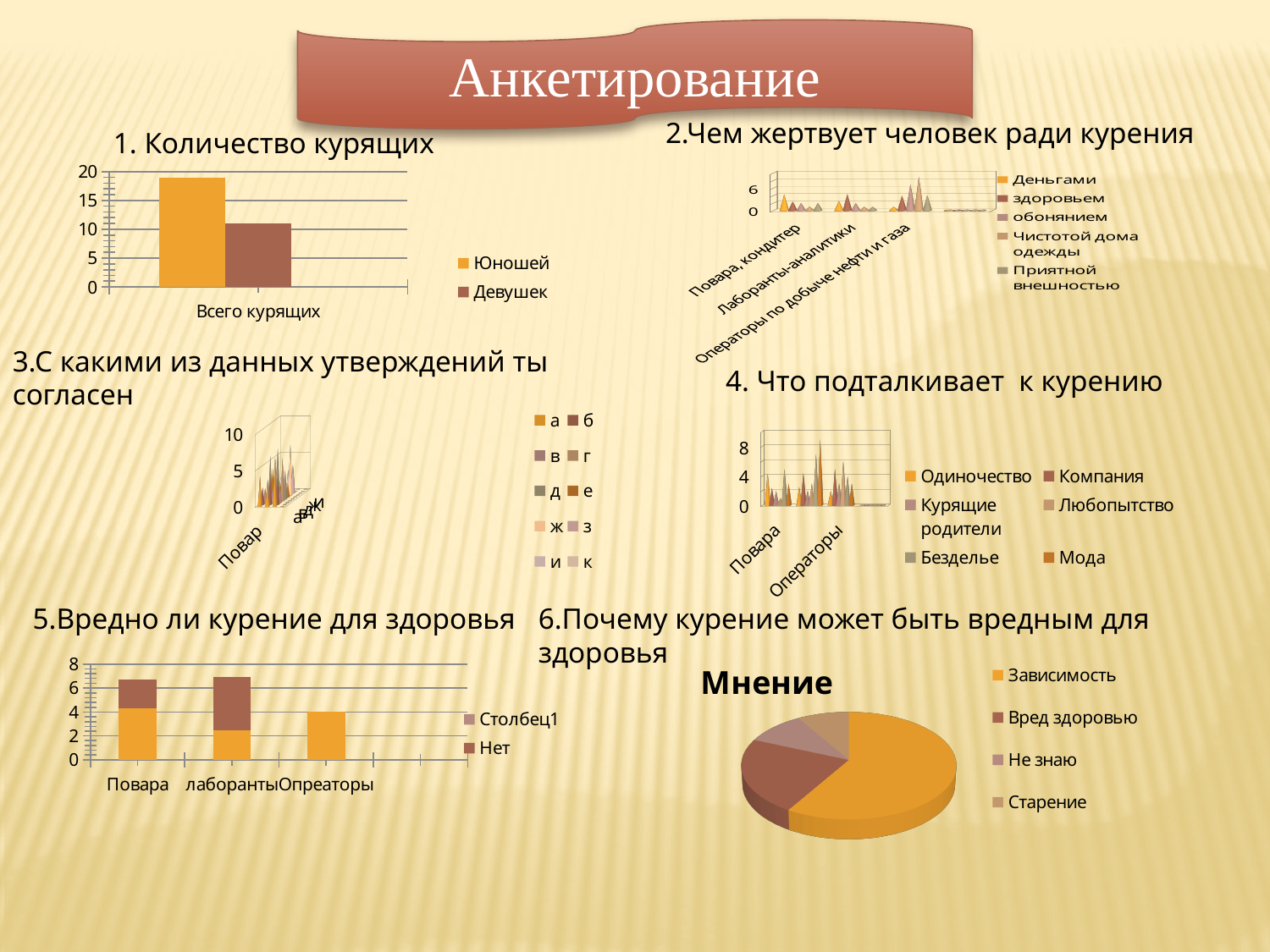
What kind of chart is chart 6, "Мнение"? pie chart What are the two legend entries of chart 5, "Вредно ли курение для здоровья"? Столбец1, Нет In chart 6, "Мнение", which legend entry corresponds to the largest slice? Зависимость In chart 5, "Вредно ли курение для здоровья", is the total stacked value for Повара greater or less than 6? greater In chart 1, "Количество курящих", is the value for Девушек greater or less than 15? less How many series does the legend of chart 2, "Чем жертвует человек ради курения", list? 5 How many series does the legend of chart 3, "С какими из данных утверждений ты согласен", list? 10 How many categories are shown on the x axis of chart 2, "Чем жертвует человек ради курения"? 3 In chart 1, "Количество курящих", is the value for Юношей greater or less than 15? greater In chart 1, "Количество курящих", which series has the taller bar, Юношей or Девушек? Юношей How many series does the legend of chart 4, "Что подталкивает к курению", list? 6 What kind of chart is chart 1, "Количество курящих"? bar chart